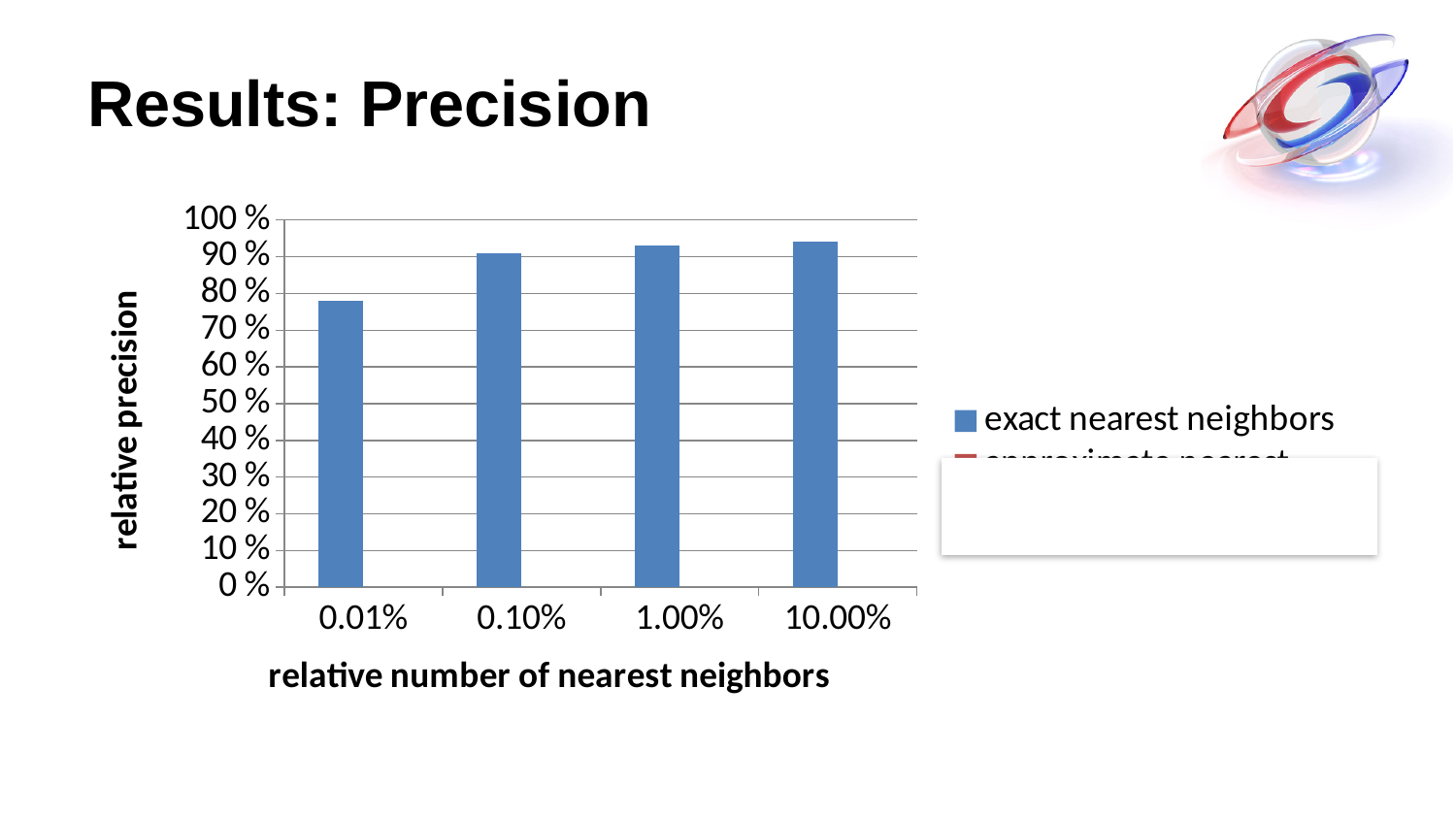
Do the relative precision values rise or fall as the relative number of nearest neighbors increases along the x axis? rise What kind of chart is shown on the slide? bar chart Is the relative precision for 0.01% greater or less than 90 %? less Is the relative precision for 1.00% greater or less than 90 %? greater How many categories are shown on the x axis of the chart? 4 Which has the higher relative precision, 0.01% or 0.10%? 0.10% What is the first series listed in the chart legend? exact nearest neighbors Is the relative precision for 10.00% greater or less than 90 %? greater What is the title of the y axis of the chart? relative precision Which category has the lowest relative precision? 0.01%